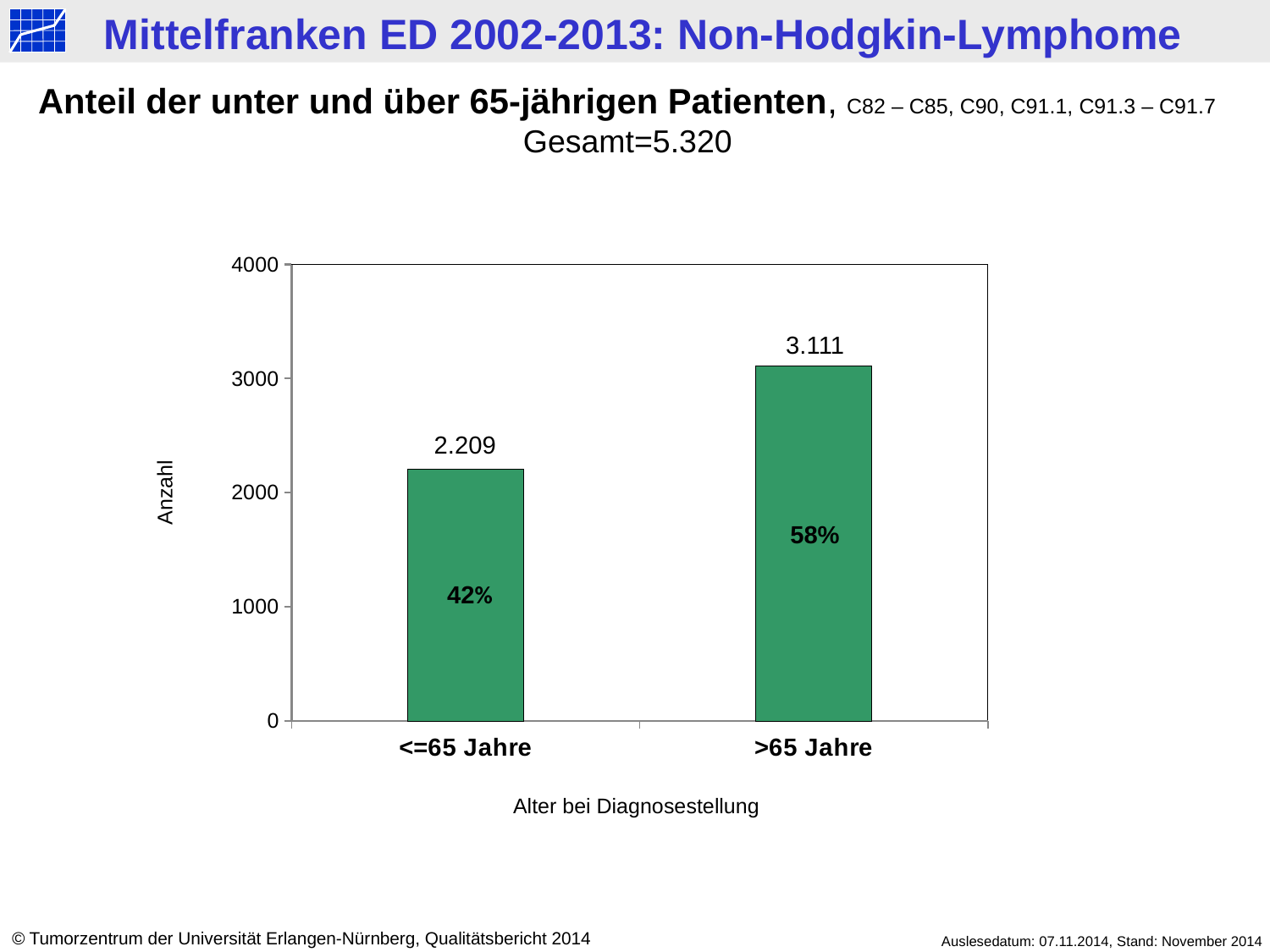
Which category has the lowest value? <=65 Jahre What is the label of the x axis? Alter bei Diagnosestellung What is the value for the >65 Jahre category? 3.111 What kind of chart is shown on the slide? bar chart Is the value for <=65 Jahre greater or less than 2000? greater Which is larger, the value for <=65 Jahre or the value for >65 Jahre? >65 Jahre Which category has the highest value? >65 Jahre What is the difference between the values for >65 Jahre and <=65 Jahre? 902 Is the value for >65 Jahre greater or less than 4000? less What is the value for the <=65 Jahre category? 2.209 How many categories are shown on the x axis? 2 What percentage label is shown inside the bar for >65 Jahre? 58%